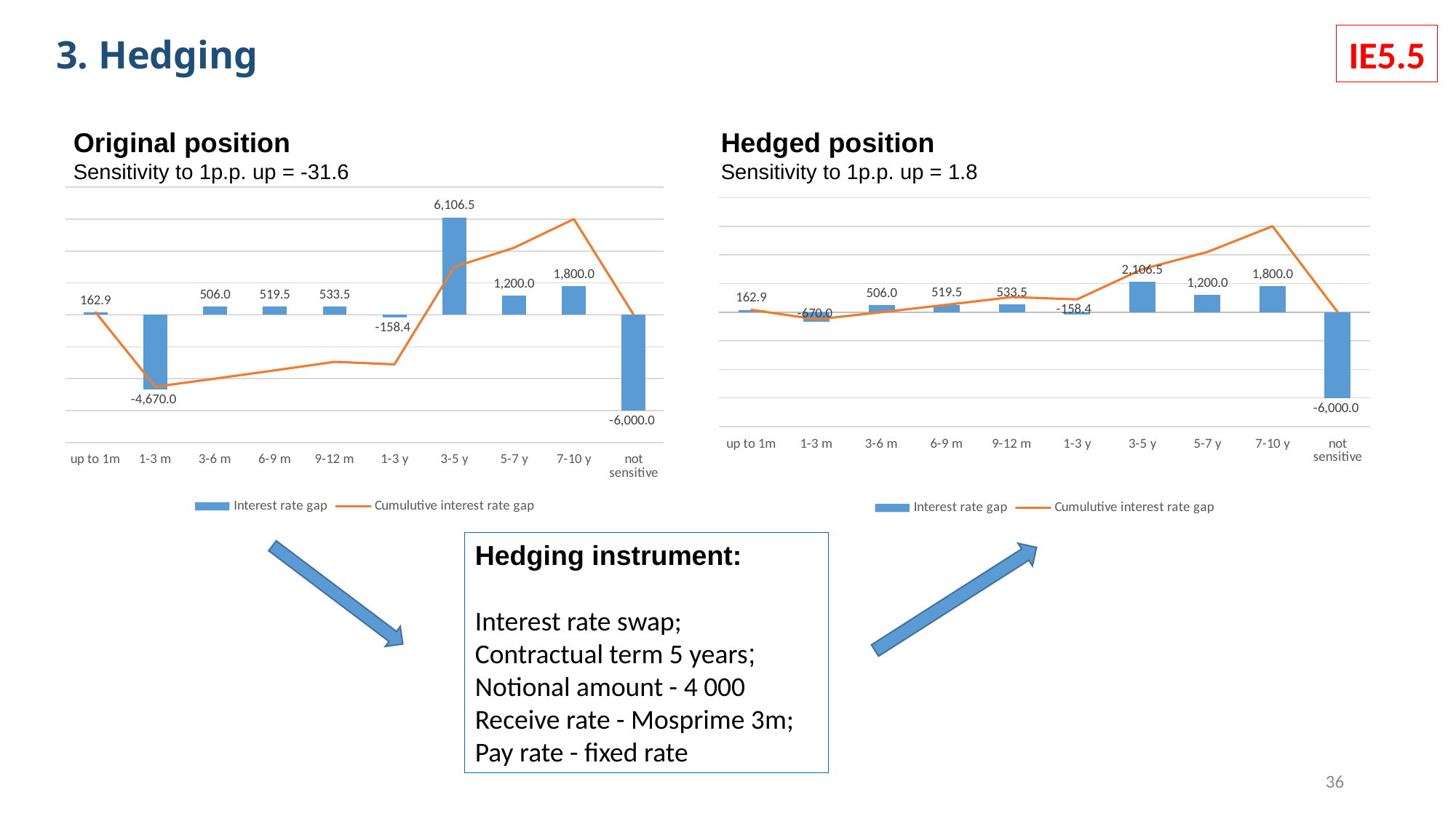
What kind of chart is the Original position chart? Combined bar and line chart How many series does the legend of the Hedged position chart list? 2 In the Hedged position chart, what is the interest rate gap for the 1-3 m bucket? -670.0 In the Hedged position chart, which is larger: the interest rate gap for 7-10 y or for 5-7 y? 7-10 y In the Original position chart, which bucket has the highest interest rate gap? 3-5 y In the Hedged position chart, which series is drawn as an orange line? Cumulutive interest rate gap In the Original position chart, what is the interest rate gap for the 1-3 m bucket? -4,670.0 In the Original position chart, what is the interest rate gap for the 3-5 y bucket? 6,106.5 In the Hedged position chart, what is the interest rate gap for the 3-5 y bucket? 2,106.5 In the Original position chart, which bucket has the lowest interest rate gap? not sensitive What is the difference between the 3-5 y interest rate gap in the Original position chart and in the Hedged position chart? 4,000.0 How many maturity buckets are shown on the x axis of the Original position chart? 10